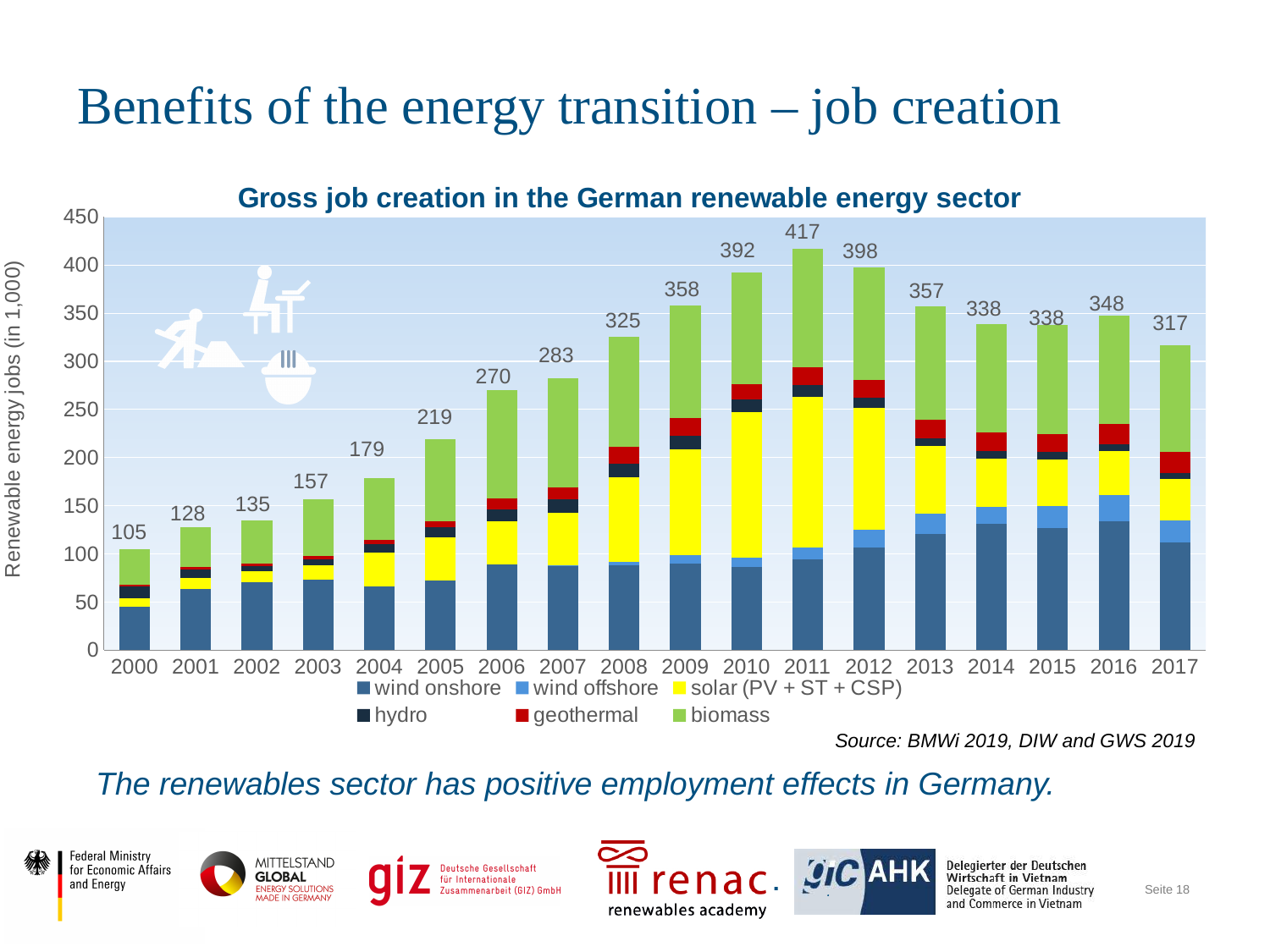
How many years are shown on the x axis? 18 By how much did the total fall from 2012 to 2013? 41 Which year has the highest total gross job creation? 2011 Is the wind onshore value for 2016 greater or less than 100? greater What is the difference between the total for 2011 and the total for 2000? 312 What is the total gross job creation shown for 2011? 417 What kind of chart is used to show gross job creation? Stacked bar chart How many series does the legend list? 6 What is the total value shown for 2017? 317 What is the total value labelled above the bar for 2005? 219 Which year has the lowest total gross job creation? 2000 Which year has a larger total, 2009 or 2016? 2009